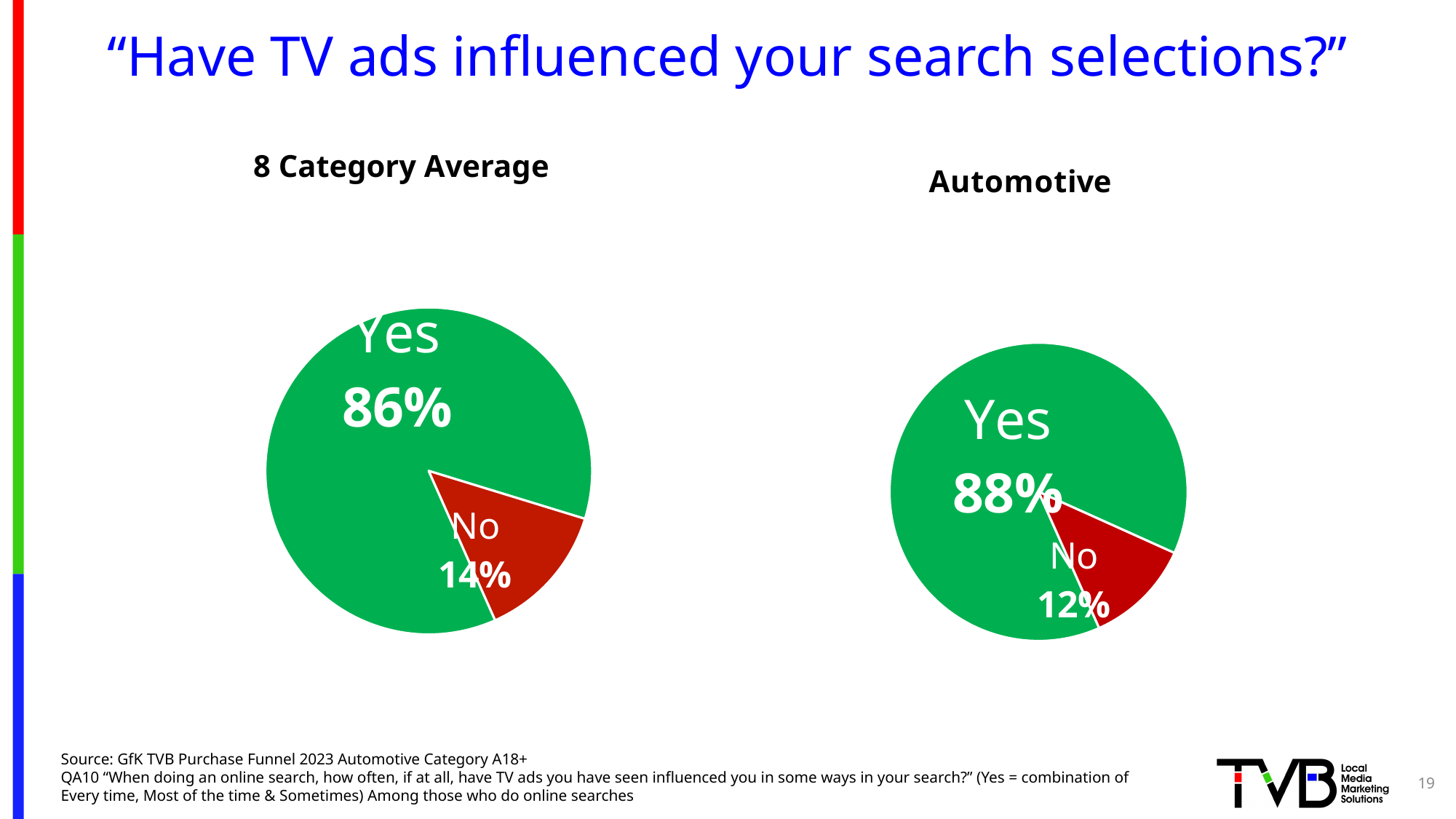
What kind of chart is the 8 Category Average chart? Pie chart In the Automotive chart, which slice is the largest? Yes Which chart has the larger Yes share, 8 Category Average or Automotive? Automotive In the Automotive chart, what percentage answered No? 12% In the 8 Category Average chart, what colour is the Yes slice? Green In the 8 Category Average chart, which slice is the smallest? No In the Automotive chart, what percentage answered Yes? 88% In the Automotive chart, what is the difference between the Yes and No percentages? 76% How many slices does the Automotive pie chart have? 2 In the 8 Category Average chart, what percentage answered Yes? 86% In the 8 Category Average chart, what percentage answered No? 14% In the 8 Category Average chart, what is the difference between the Yes and No percentages? 72%